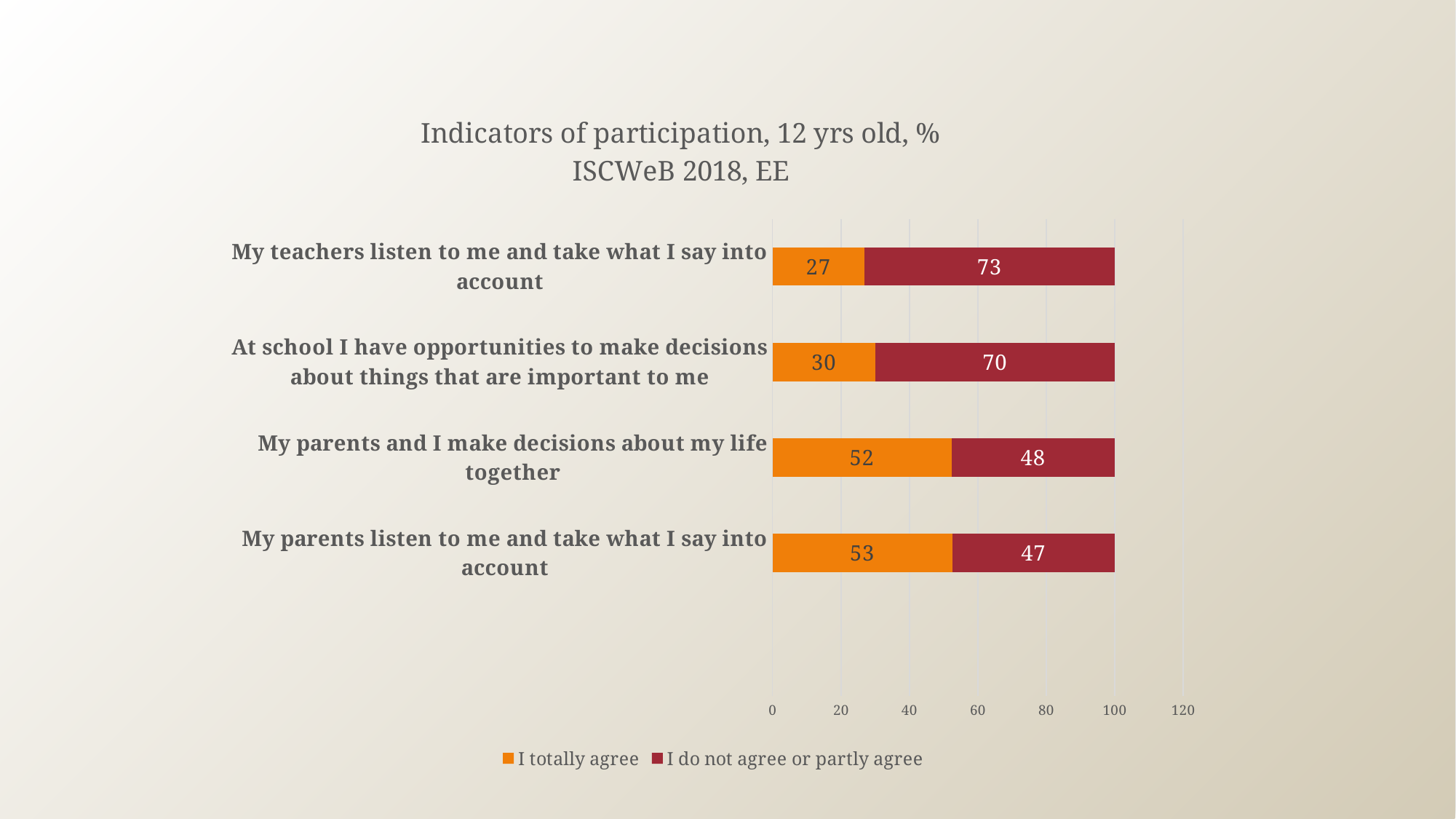
How many categories are shown on the chart? 4 Which category has the lowest 'I totally agree' value? My teachers listen to me and take what I say into account What is the difference between the 'I do not agree or partly agree' values for 'My teachers listen to me and take what I say into account' and 'My parents and I make decisions about my life together'? 25 How many series does the legend list? 2 Which is larger: the 'I totally agree' value for 'At school I have opportunities to make decisions about things that are important to me' or for 'My parents and I make decisions about my life together'? My parents and I make decisions about my life together What kind of chart is shown on the slide? Stacked bar chart What is the 'I do not agree or partly agree' value for 'At school I have opportunities to make decisions about things that are important to me'? 70 What is the total of the stacked bar for 'My parents and I make decisions about my life together'? 100 What is the 'I totally agree' value for 'My teachers listen to me and take what I say into account'? 27 What is the 'I totally agree' value for 'My parents listen to me and take what I say into account'? 53 Which category has the highest 'I totally agree' value? My parents listen to me and take what I say into account What is the title of the chart? Indicators of participation, 12 yrs old, % ISCWeB 2018, EE